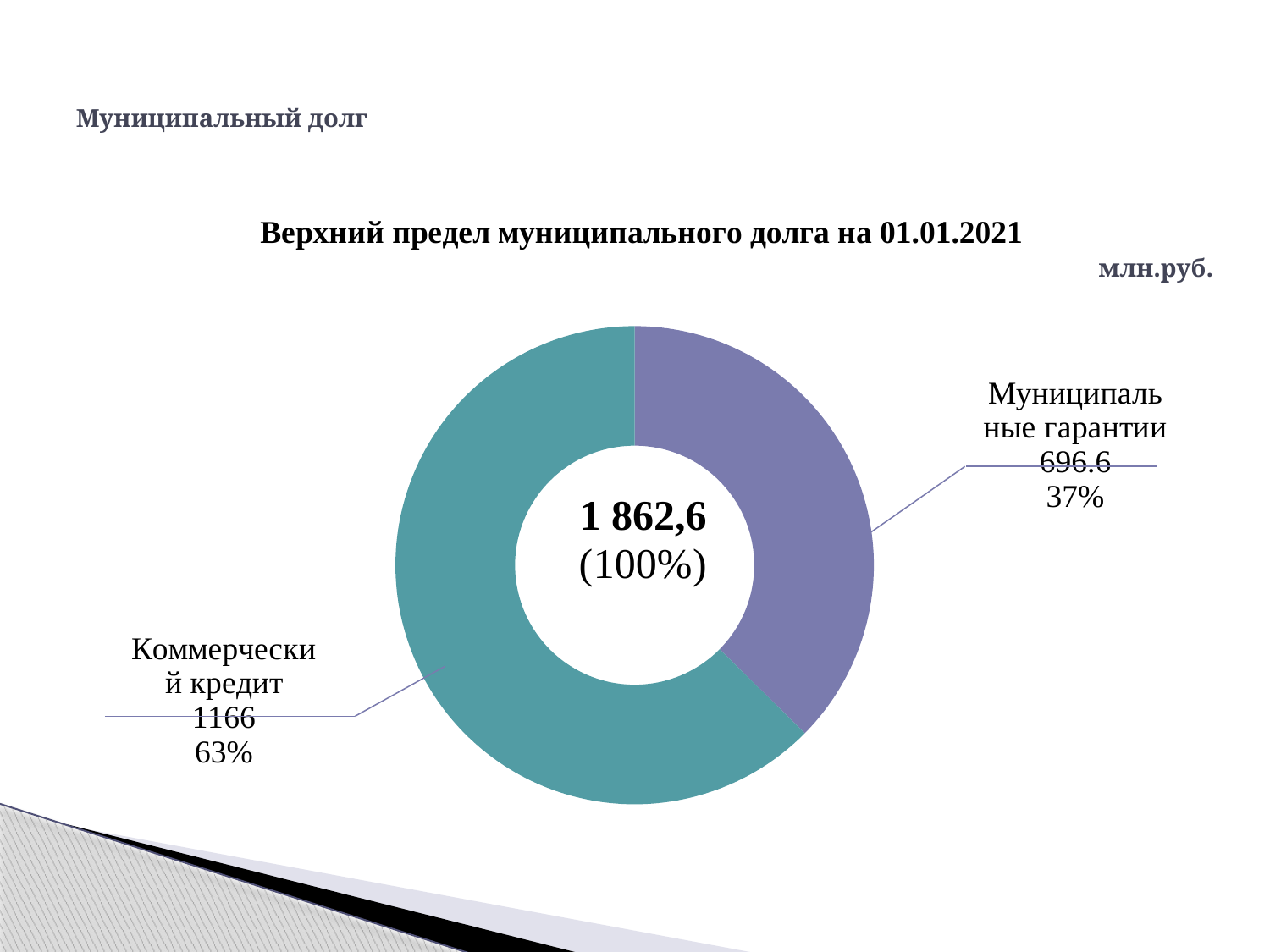
What is the value for Коммерческий кредит? 1166 What is the title of the chart? Верхний предел муниципального долга на 01.01.2021 What share of the chart does Муниципальные гарантии represent? 37% Which category has the largest value? Коммерческий кредит What is the total value shown in the centre of the chart? 1 862,6 Which is larger, Коммерческий кредит or Муниципальные гарантии? Коммерческий кредит What is the value for Муниципальные гарантии? 696.6 What is the difference between the values for Коммерческий кредит and Муниципальные гарантии? 469.4 Which category has the smallest value? Муниципальные гарантии How many categories does the chart show? 2 What share of the chart does Коммерческий кредит represent? 63% What kind of chart is shown on the slide? Doughnut (pie) chart